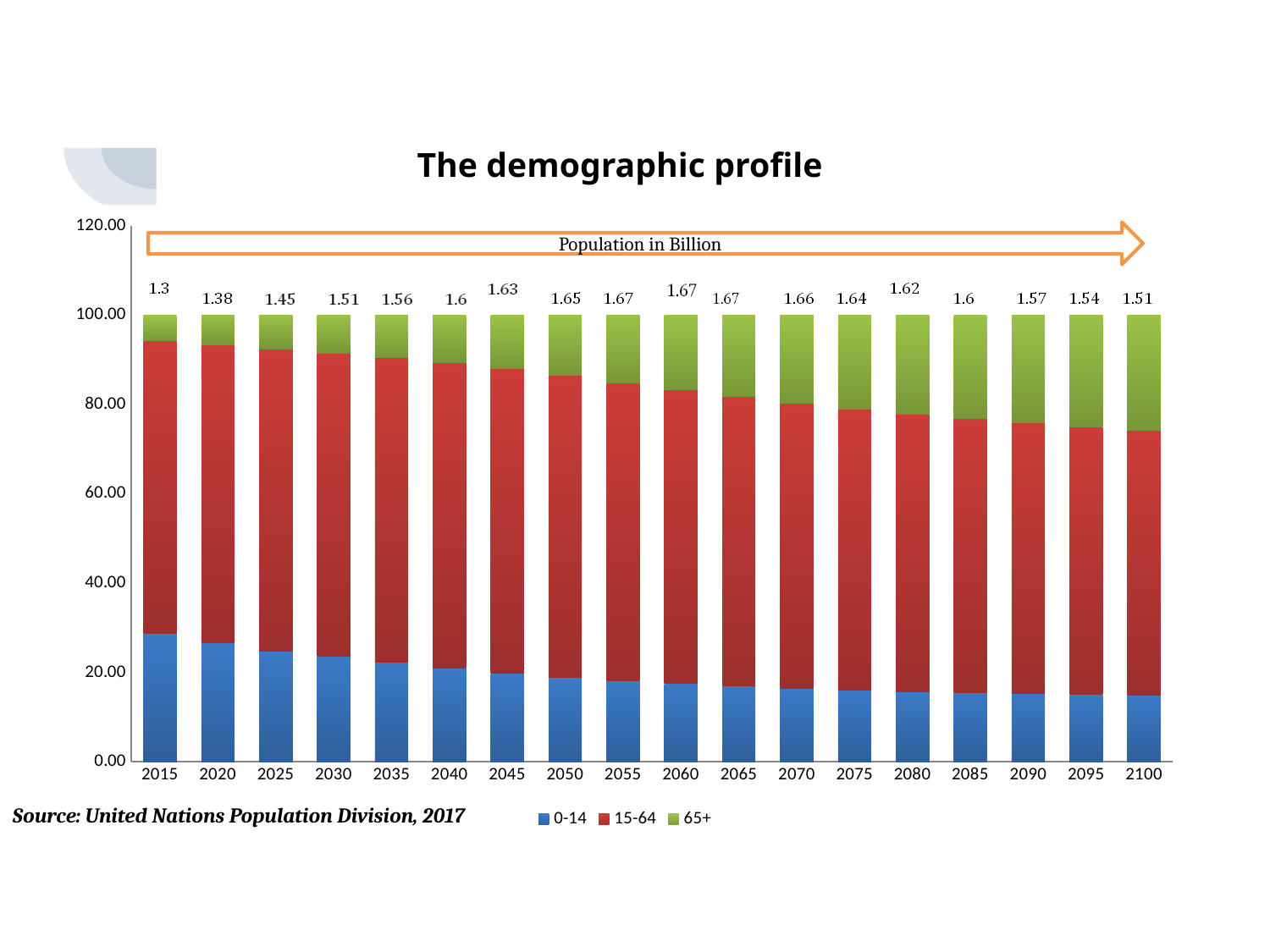
Is the value of the 0-14 segment for 2100 greater or less than 20? less What population value (in billion) is printed above the bar for 2015? 1.3 Is the value of the 0-14 segment for 2015 greater or less than 20? greater How many series does the legend list? 3 How many years are shown on the x axis? 18 What population value (in billion) is printed above the bar for 2100? 1.51 Which year has the larger printed population value, 2020 or 2095? 2095 What kind of chart is shown on the slide? Stacked bar chart What is the difference between the population values printed for 2100 and 2015? 0.21 Does the share of the 0-14 age group rise or fall from 2015 to 2100? Fall Which year has the lowest population value printed above its bar? 2015 What population value (in billion) is printed above the bar for 2045? 1.63